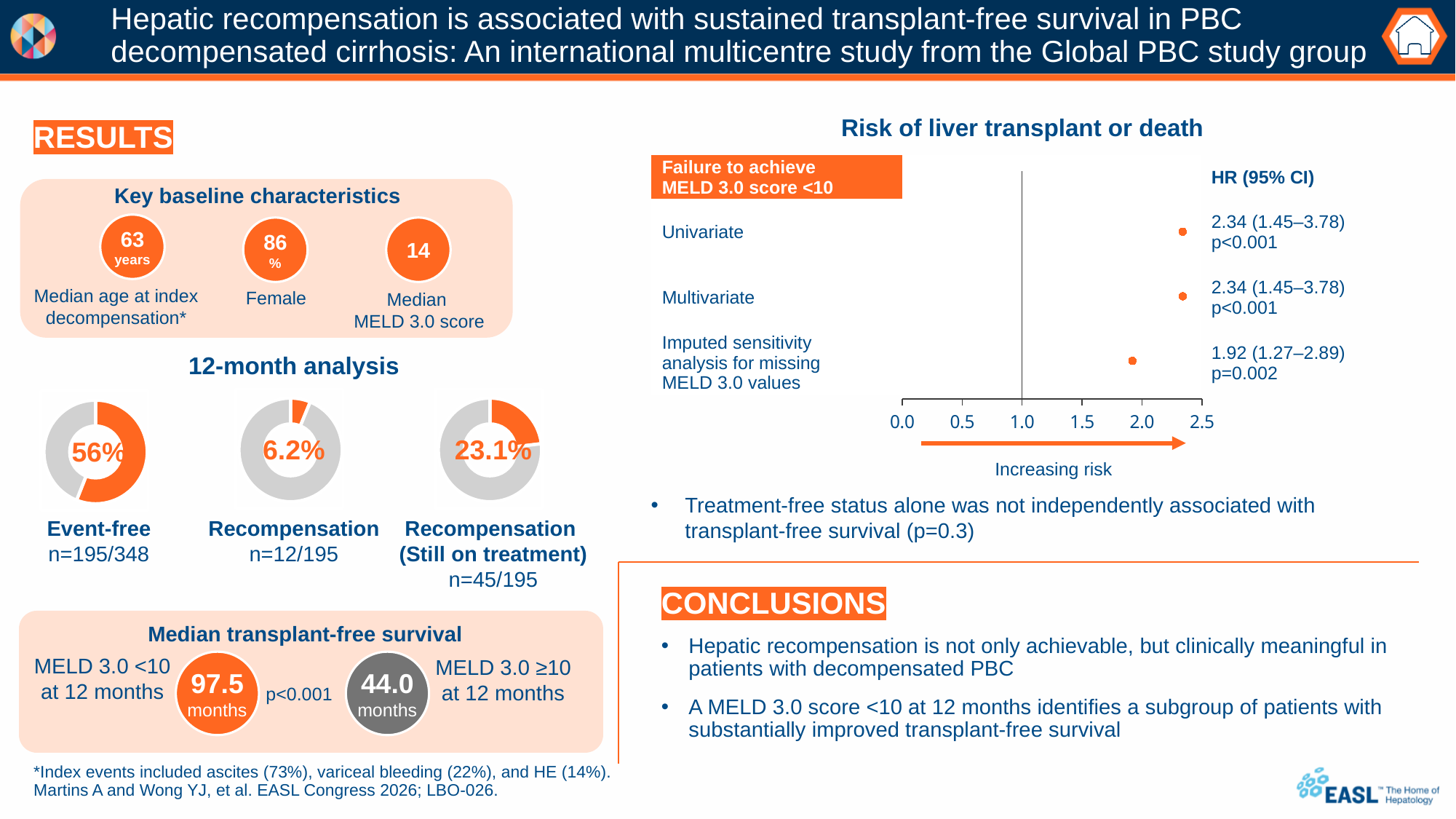
In the 'Risk of liver transplant or death' chart, how many analyses (rows) are plotted? 3 In the 'Risk of liver transplant or death' chart, what is the p-value for the Multivariate analysis? p<0.001 In the 'Risk of liver transplant or death' chart, what is the hazard ratio (95% CI) for the Imputed sensitivity analysis for missing MELD 3.0 values? 1.92 (1.27–2.89) In the 12-month analysis donut charts, which category has the smallest percentage? Recompensation In the 12-month analysis donut charts, what percentage is shown for Recompensation (Still on treatment)? 23.1% In the 'Risk of liver transplant or death' chart, what is the hazard ratio (95% CI) for the Univariate analysis? 2.34 (1.45–3.78) In the 'Risk of liver transplant or death' chart, which analysis has the lowest hazard ratio? Imputed sensitivity analysis for missing MELD 3.0 values In the 'Risk of liver transplant or death' chart, is the hazard ratio for the Imputed sensitivity analysis greater or less than 2.0? less In the 12-month analysis donut charts, what percentage is shown for Event-free? 56% In the 'Risk of liver transplant or death' chart, what is the maximum value shown on the x axis? 2.5 In the 'Risk of liver transplant or death' chart, what does the arrow below the x axis indicate? Increasing risk In the 'Risk of liver transplant or death' chart, is the hazard ratio for the Univariate analysis greater or less than 2.0? greater